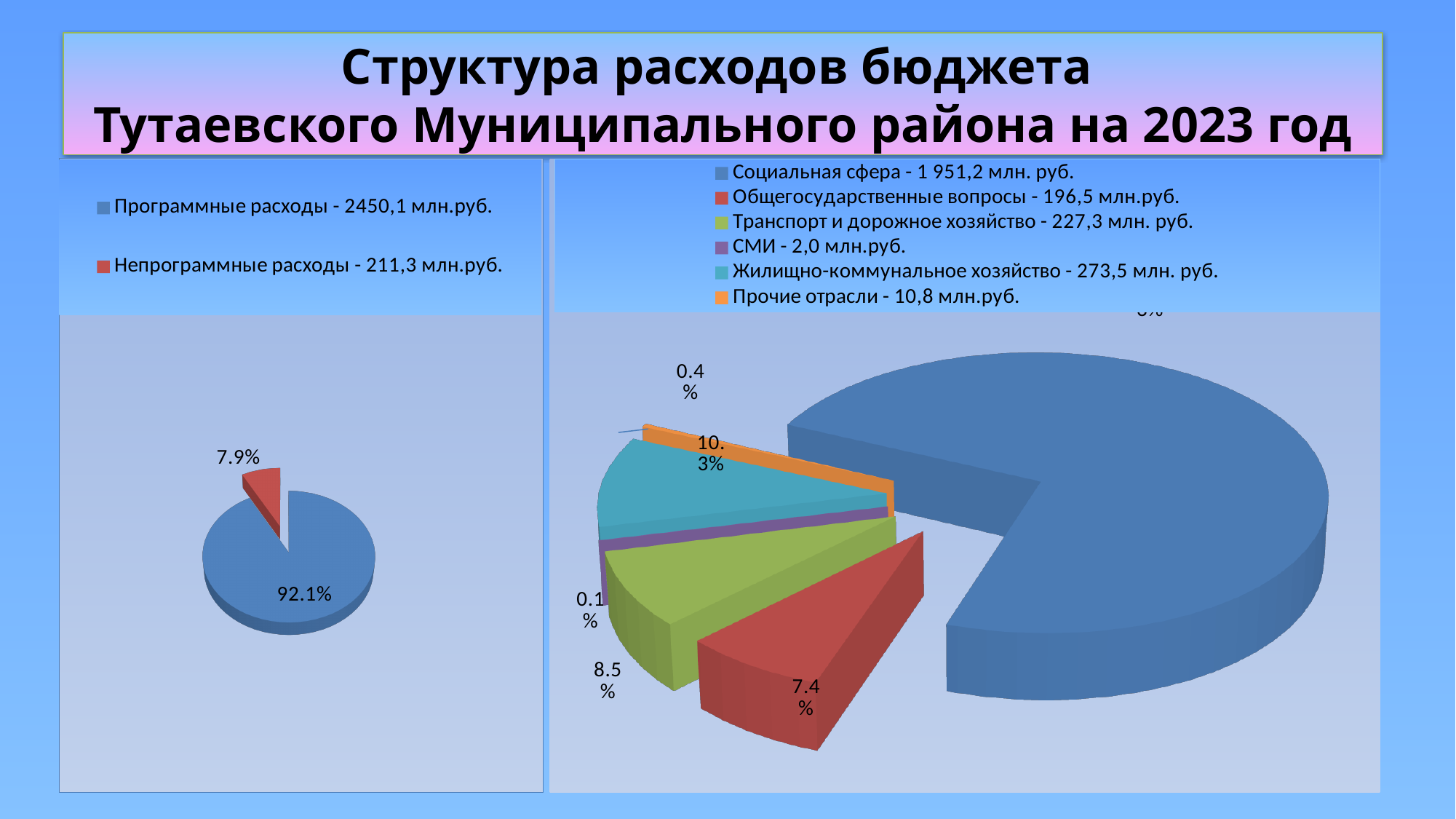
How many categories does the legend of the left pie chart list? 2 In the right pie chart, what share is shown for Жилищно-коммунальное хозяйство? 10.3% What kind of chart is the left chart on the slide? pie chart In the left pie chart, what share is shown for Непрограммные расходы? 7.9% In the right pie chart, which is larger: the slice for Транспорт и дорожное хозяйство or the slice for Общегосударственные вопросы? Транспорт и дорожное хозяйство How many categories does the legend of the right pie chart list? 6 In the right chart's legend, what amount is given for СМИ? 2,0 млн.руб. In the right chart's legend, what amount is given for Социальная сфера? 1 951,2 млн. руб. In the right pie chart, which category has the largest slice? Социальная сфера In the left pie chart, what share is shown for Программные расходы? 92.1% In the left chart's legend, what amount is given for Программные расходы? 2450,1 млн.руб. In the right pie chart, which category has the smallest slice? СМИ